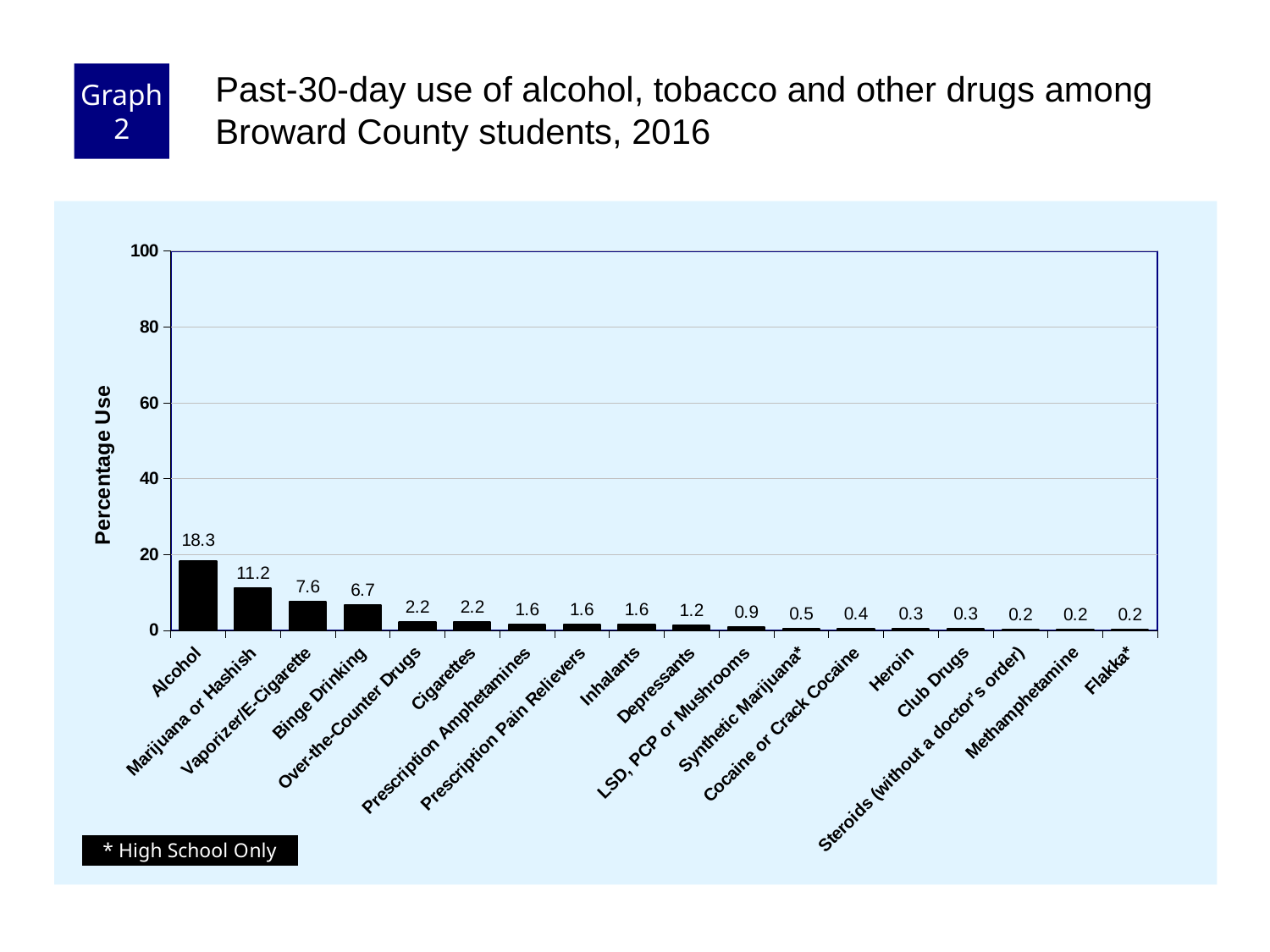
What is the percentage use for Binge Drinking? 6.7 What is the percentage use for Alcohol? 18.3 What is the percentage use for Heroin? 0.3 What is the label of the y axis? Percentage Use Is the value for Alcohol greater or less than 20? less Which has a higher percentage use, Cigarettes or Inhalants? Cigarettes What kind of chart is shown on the slide? bar chart What is the percentage use for Marijuana or Hashish? 11.2 What is the difference in percentage use between Vaporizer/E-Cigarette and Binge Drinking? 0.9 Which category has the highest percentage use? Alcohol What is the difference in percentage use between Alcohol and Marijuana or Hashish? 7.1 How many categories are shown on the x axis? 18